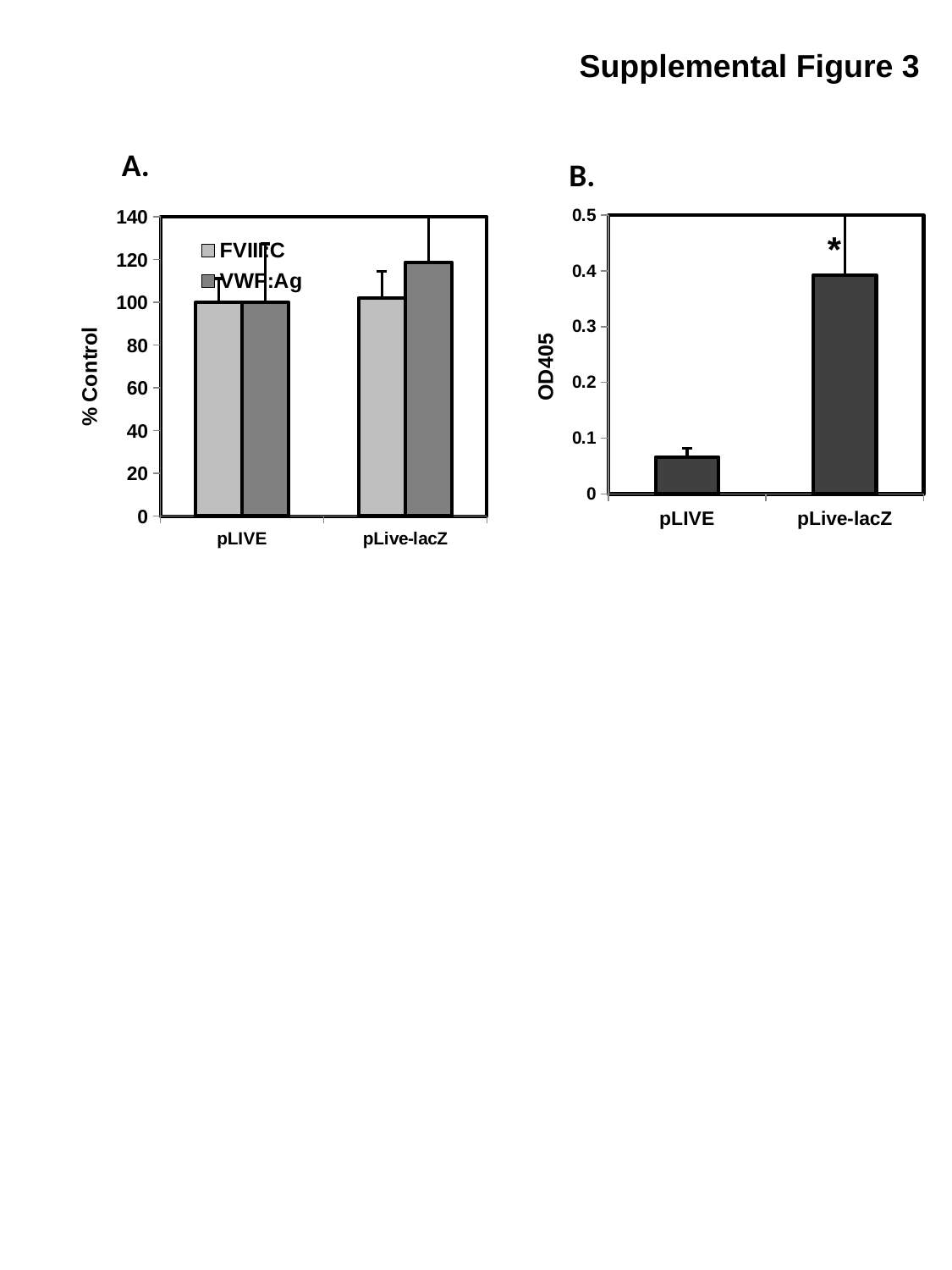
In chart B (right), what is the y-axis title? OD405 In chart A (left), what are the two series named in the legend? FVIII:C and VWF:Ag In chart A (left), how many categories are shown on the x axis? 2 In chart A (left), is the VWF:Ag value for pLive-lacZ greater or less than 100? greater In chart A (left), what is the % Control value for FVIII:C in the pLIVE group? 100 In chart B (right), is the value for pLive-lacZ greater or less than 0.3? greater In chart A (left), how many series does the legend list? 2 In chart A (left), what kind of chart is shown? bar chart In chart B (right), is the value for pLIVE greater or less than 0.1? less In chart B (right), which category has the higher OD405 value? pLive-lacZ In chart A (left), which is larger: the VWF:Ag value for pLIVE or for pLive-lacZ? pLive-lacZ In chart A (left), which bar is the highest? VWF:Ag for pLive-lacZ